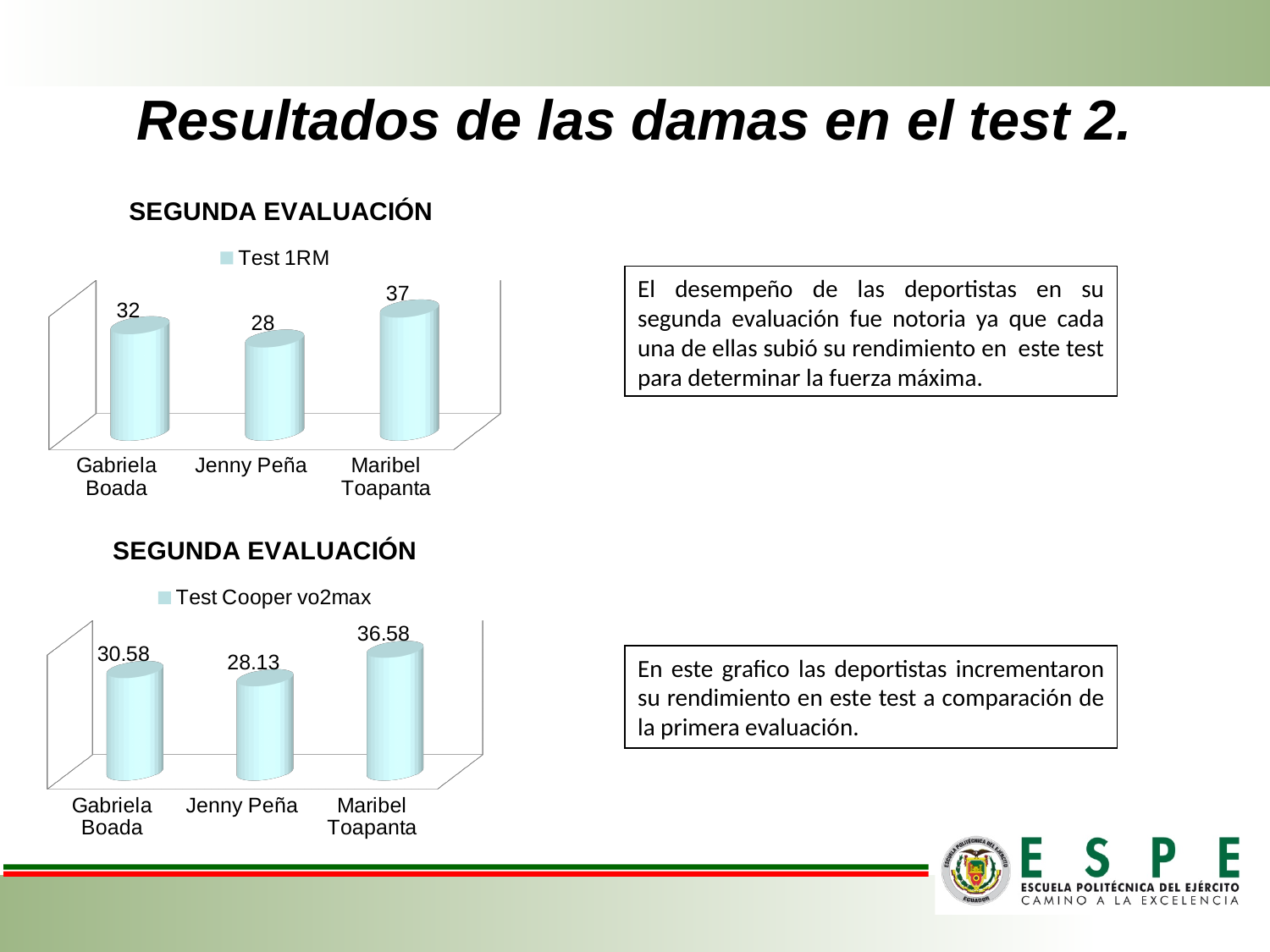
In the bottom chart (Test Cooper vo2max), is the value for Gabriela Boada larger or smaller than the value for Maribel Toapanta? smaller How many athletes are shown in the top chart (Test 1RM)? 3 In the top chart (Test 1RM), which athlete has the lowest value? Jenny Peña In the top chart (Test 1RM), what is the difference between Maribel Toapanta's and Jenny Peña's values? 9 What type of chart is the bottom chart (Test Cooper vo2max)? bar chart In the bottom chart (Test Cooper vo2max), what is the value for Maribel Toapanta? 36.58 In the top chart (Test 1RM), what is the value for Jenny Peña? 28 In the bottom chart (Test Cooper vo2max), what is the difference between Gabriela Boada's and Jenny Peña's values? 2.45 In the top chart (Test 1RM), which athlete has the highest value? Maribel Toapanta In the top chart (Test 1RM), what is the value for Gabriela Boada? 32 In the bottom chart (Test Cooper vo2max), which athlete has the lowest value? Jenny Peña In the bottom chart (Test Cooper vo2max), what is the value for Jenny Peña? 28.13